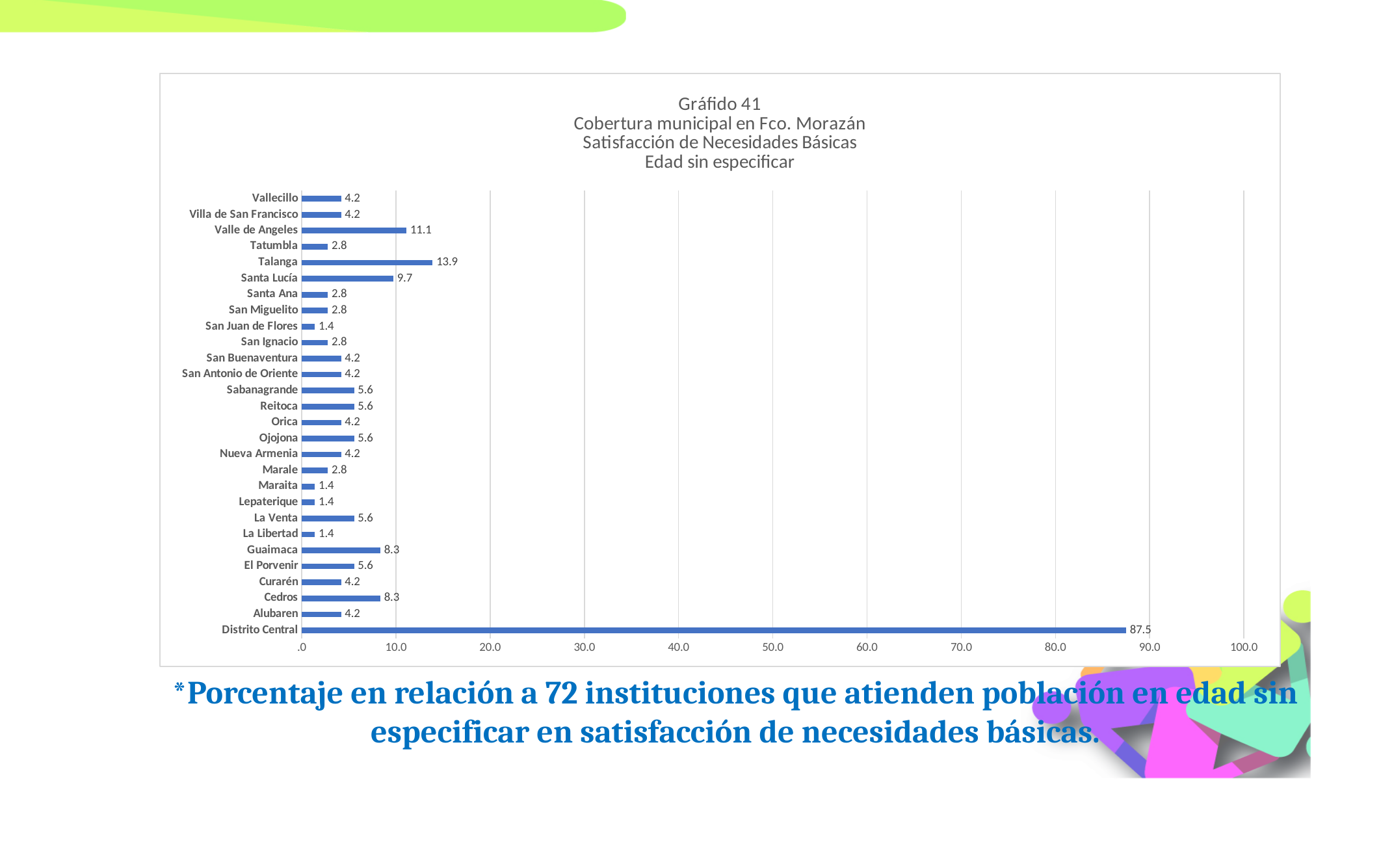
Which has a larger value, Santa Lucía or Cedros? Santa Lucía What kind of chart is shown on the slide? Bar chart How many municipalities are shown in the chart? 28 Which municipality has the highest value? Distrito Central What is the number of the chart given in its title? Gráfido 41 What is the value for Talanga? 13.9 What is the value for Distrito Central? 87.5 Is the value for Distrito Central greater or less than 80.0? greater What is the difference between the values for Distrito Central and Talanga? 73.6 What is the value for Valle de Angeles? 11.1 What is the difference between the values for Guaimaca and Tatumbla? 5.5 What is the value for Santa Lucía? 9.7